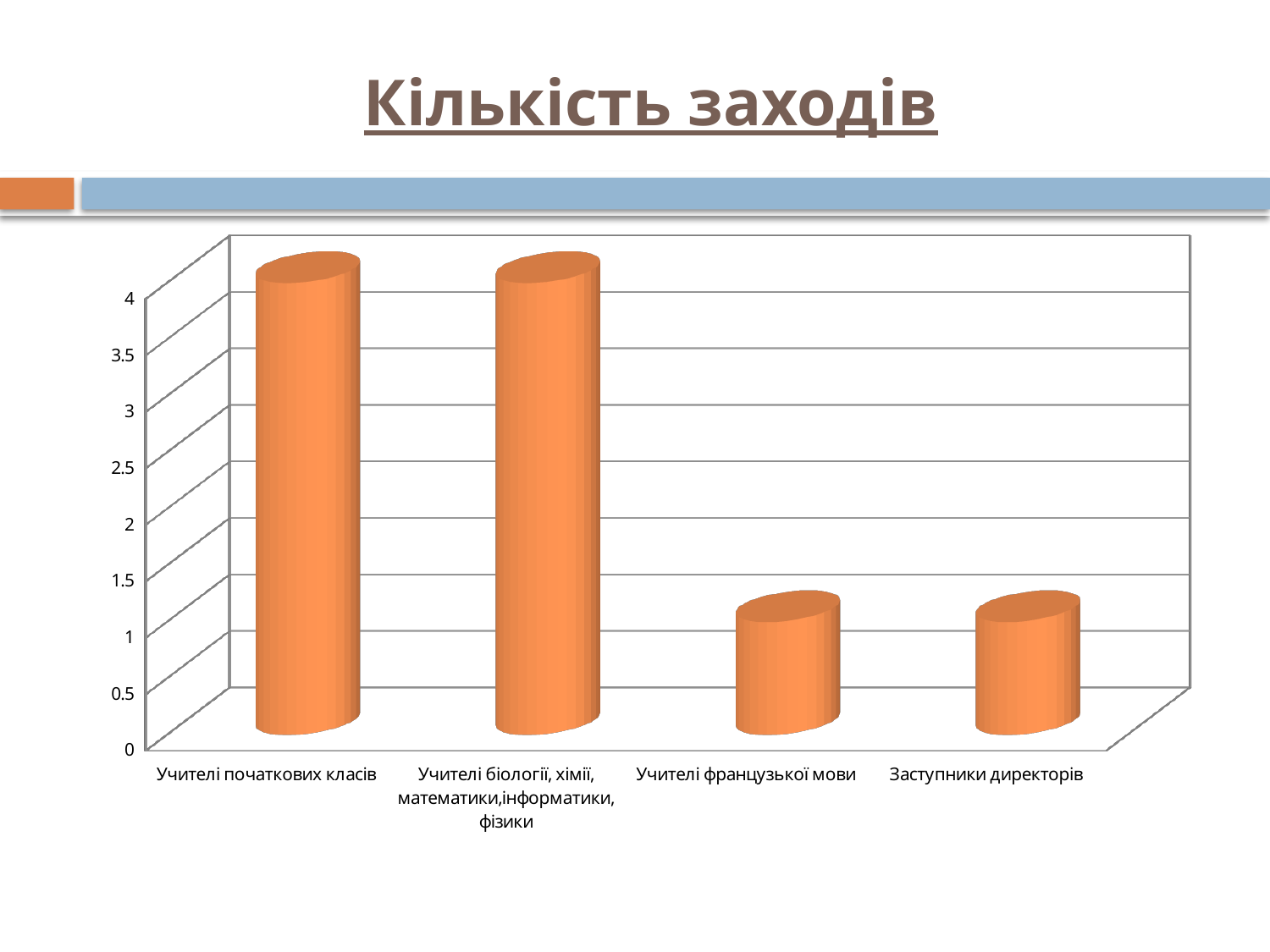
What is the title of the chart on the slide? Кількість заходів Is the value for Учителі біології, хімії, математики,інформатики, фізики greater or less than 3? greater Do the values rise or fall moving from left to right along the x axis? fall Is the value for Учителі французької мови greater or less than 2? less What kind of chart is shown on the slide? bar chart Is the value for Учителі початкових класів greater or less than 3? greater What colour are the bars in the chart? orange Which is larger: the value for Учителі початкових класів or the value for Учителі французької мови? Учителі початкових класів Which is larger: the value for Заступники директорів or the value for Учителі біології, хімії, математики,інформатики, фізики? Учителі біології, хімії, математики,інформатики, фізики How many categories are shown on the x axis of the chart? 4